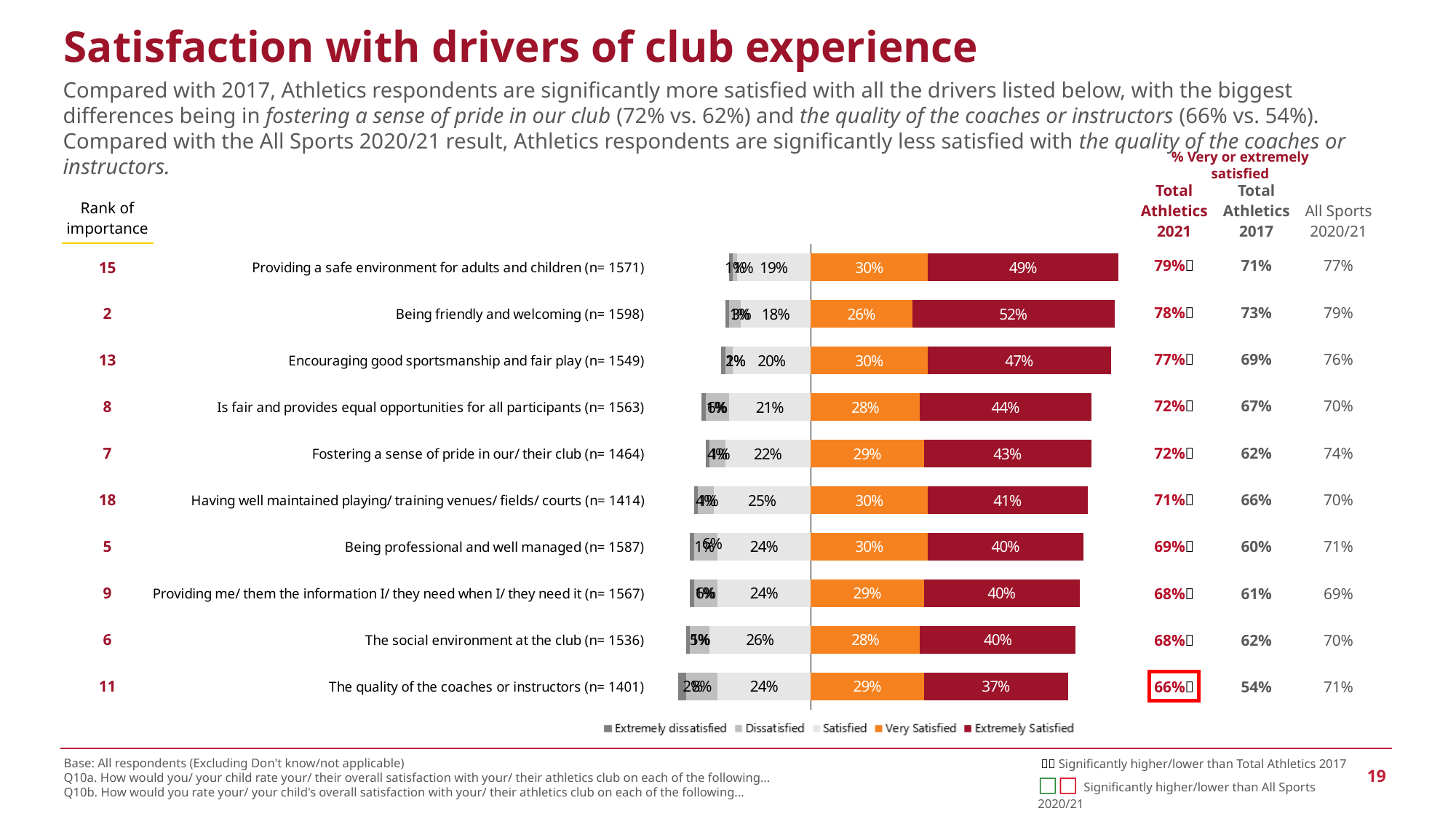
Which has the larger Very Satisfied value: 'Providing a safe environment for adults and children' or 'Being friendly and welcoming'? Providing a safe environment for adults and children How many series does the chart legend list? 5 What is the Extremely Satisfied value for 'Being friendly and welcoming'? 52% How many drivers (categories) are plotted in the chart? 10 What is the difference in Extremely Satisfied values between 'Being friendly and welcoming' and 'The quality of the coaches or instructors'? 15 percentage points Which driver has the lowest Extremely Satisfied value? The quality of the coaches or instructors What kind of chart is shown on the slide? Stacked bar chart Which driver has the highest Extremely Satisfied value? Being friendly and welcoming What is the Extremely Satisfied value for 'Having well maintained playing/ training venues/ fields/ courts'? 41% What is the Satisfied value for 'The social environment at the club'? 26% Which series in the legend is shown in orange? Very Satisfied What is the Very Satisfied value for 'The quality of the coaches or instructors'? 29%